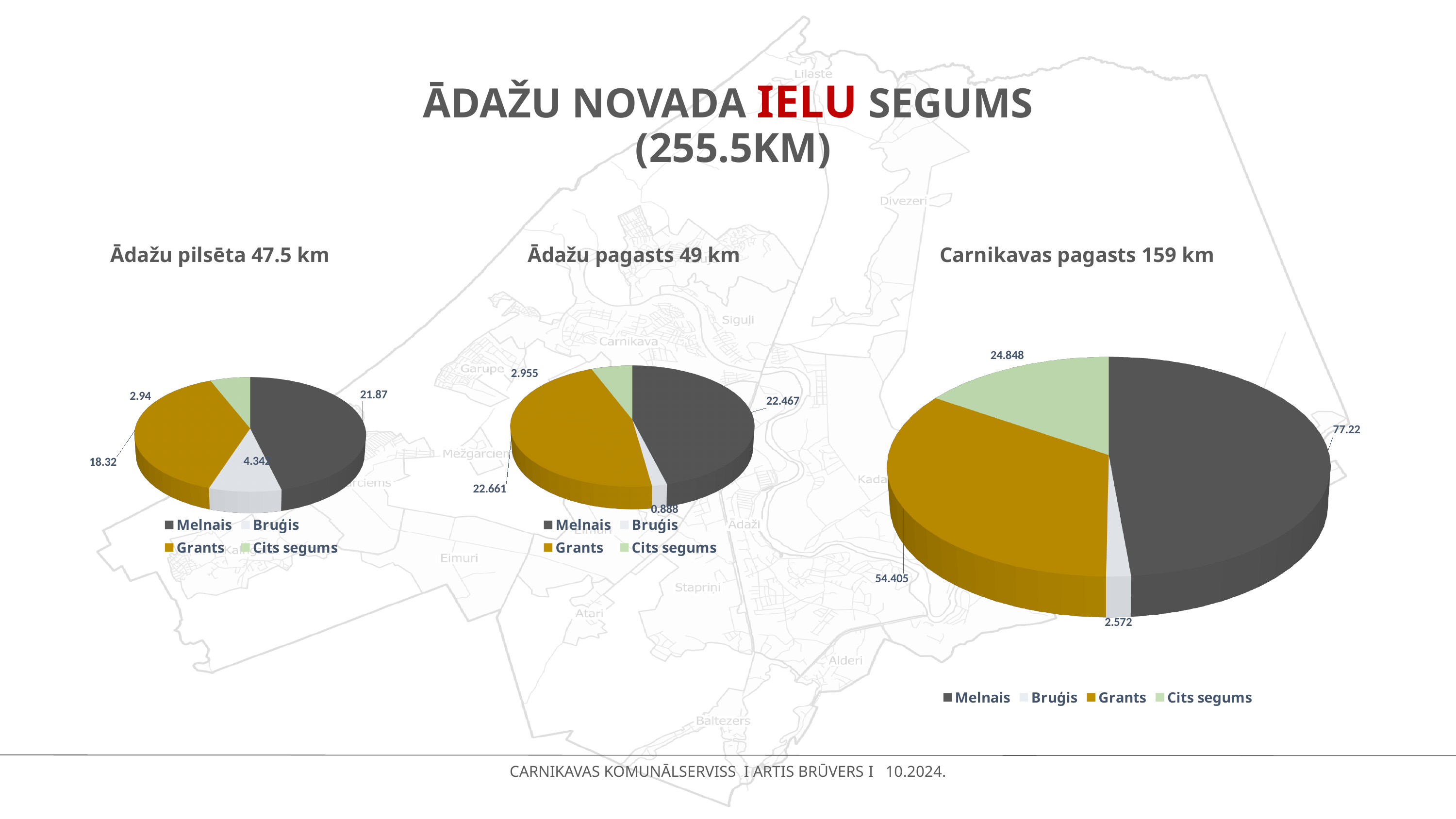
How many slices does the Ādažu pilsēta 47.5 km chart have? 4 In the Carnikavas pagasts 159 km chart, which is larger, Cits segums or Bruģis? Cits segums In the Carnikavas pagasts 159 km chart, what is the difference between the Melnais and Grants values? 22.815 In the Ādažu pilsēta 47.5 km chart, what is the value for Bruģis? 4.342 In the Ādažu pilsēta 47.5 km chart, which category has the largest slice? Melnais In the Ādažu pagasts 49 km chart, which category has the smallest slice? Bruģis What type of chart is used for Carnikavas pagasts 159 km? Pie chart In the Ādažu pagasts 49 km chart, what is the value for Cits segums? 2.955 In the Carnikavas pagasts 159 km chart, which category has the smallest slice? Bruģis In the Ādažu pagasts 49 km chart, what colour represents Grants? Gold/brown In the Carnikavas pagasts 159 km chart, what is the value for Grants? 54.405 In the Carnikavas pagasts 159 km chart, what is the value for Melnais? 77.22